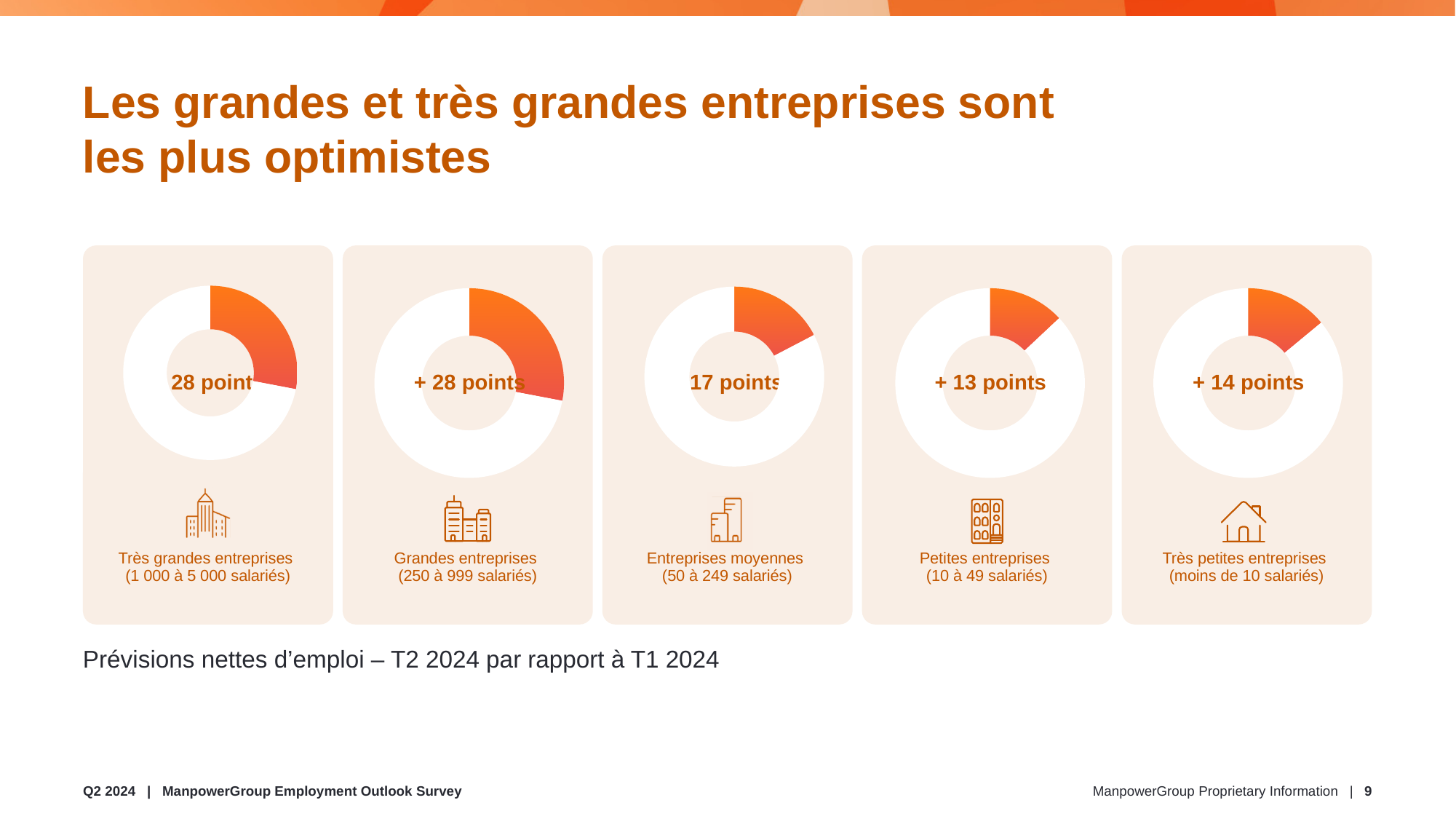
What value is shown in the donut chart for Très petites entreprises (moins de 10 salariés)? + 14 points What does the caption below the donut charts say the charts represent? Prévisions nettes d'emploi – T2 2024 par rapport à T1 2024 What value is shown in the donut chart for Grandes entreprises (250 à 999 salariés)? + 28 points Which company-size category has the lowest value among the five donut charts? Petites entreprises (10 à 49 salariés) What kind of chart is used for each company-size category on the slide? Donut chart What is the difference between the value for Grandes entreprises and the value for Petites entreprises? 15 points How many donut charts are shown on the slide? 5 Which company-size category is illustrated with a house icon below its donut chart? Très petites entreprises (moins de 10 salariés) What is the difference between the value for Très petites entreprises and the value for Petites entreprises? 1 point What value is shown in the donut chart for Petites entreprises (10 à 49 salariés)? + 13 points Which is larger: the value for Très petites entreprises or the value for Petites entreprises? Très petites entreprises Which is larger: the value for Grandes entreprises or the value for Entreprises moyennes? Grandes entreprises